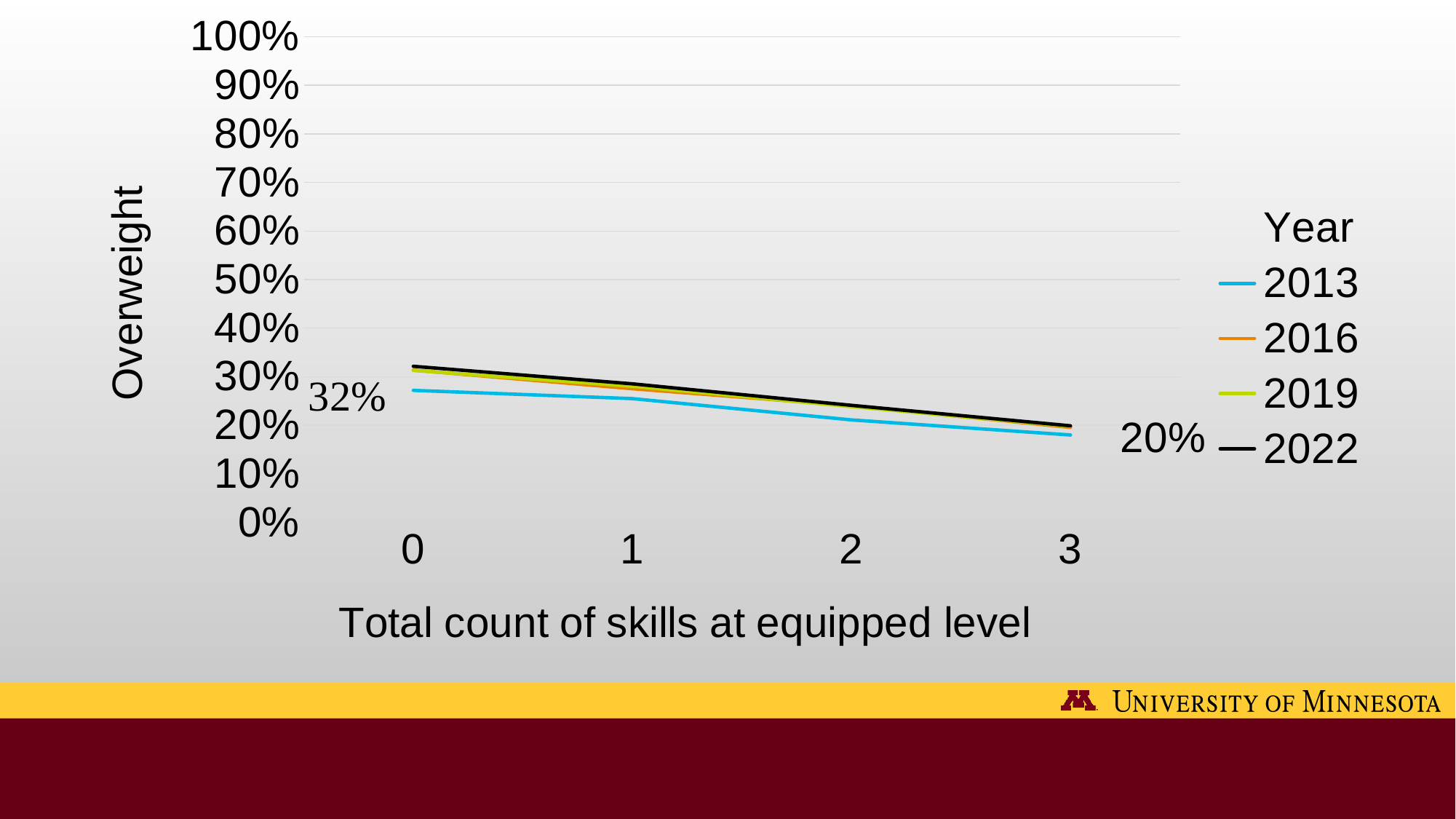
What type of chart is shown on the slide? line chart How many series does the legend list? 4 What is the title of the x axis? Total count of skills at equipped level What data label is printed at the end of the lines, at x = 3? 20% What is the title of the y axis? Overweight At x = 3, is the value for 2022 greater or less than 30%? less What data label is printed at the start of the lines, at x = 0? 32% At x = 0, is the value for 2013 greater or less than 30%? less How many points are shown along the x axis? 4 At x = 0, which is larger: the value for 2013 or the value for 2022? 2022 Do the values rise or fall as the total count of skills increases from 0 to 3? fall At x = 0, which series has the lowest value? 2013